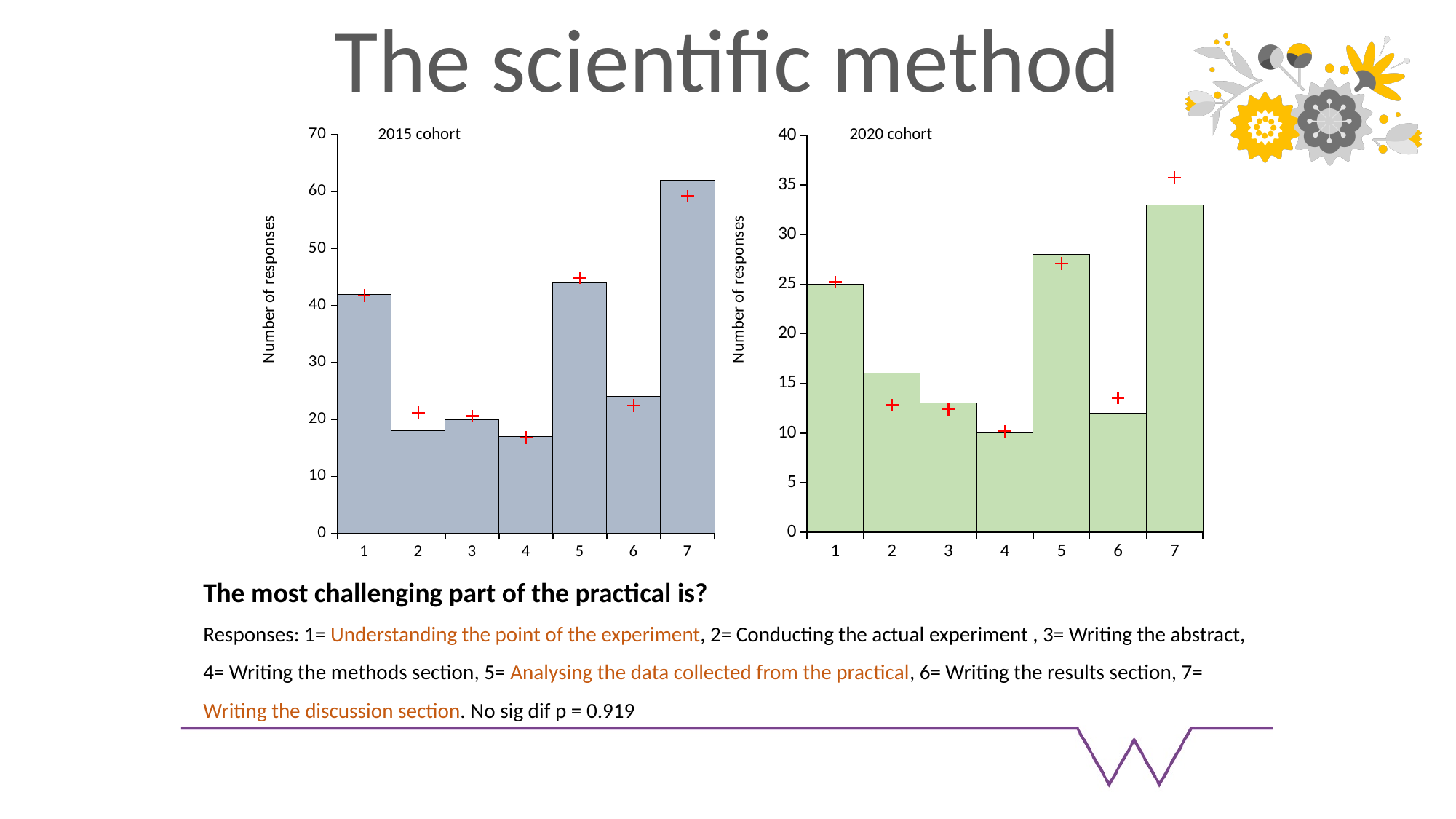
What kind of chart is the 2015 cohort chart? bar chart In the 2020 cohort chart, which category has the highest number of responses? 7 In the 2020 cohort chart, is the value for category 5 greater or less than 25? greater How many categories are shown on the x axis of the 2020 cohort chart? 7 In the 2020 cohort chart, which category has the lowest number of responses? 4 In the 2015 cohort chart, is the value for category 7 greater or less than 60? greater What is the y-axis label of the 2015 cohort chart? Number of responses In the 2020 cohort chart, which has more responses, category 2 or category 3? 2 In the 2015 cohort chart, which has more responses, category 5 or category 6? 5 In the 2015 cohort chart, which category has the highest number of responses? 7 In the 2020 cohort chart, what is the number of responses for category 4? 10 In the 2015 cohort chart, is the value for category 1 greater or less than 40? greater